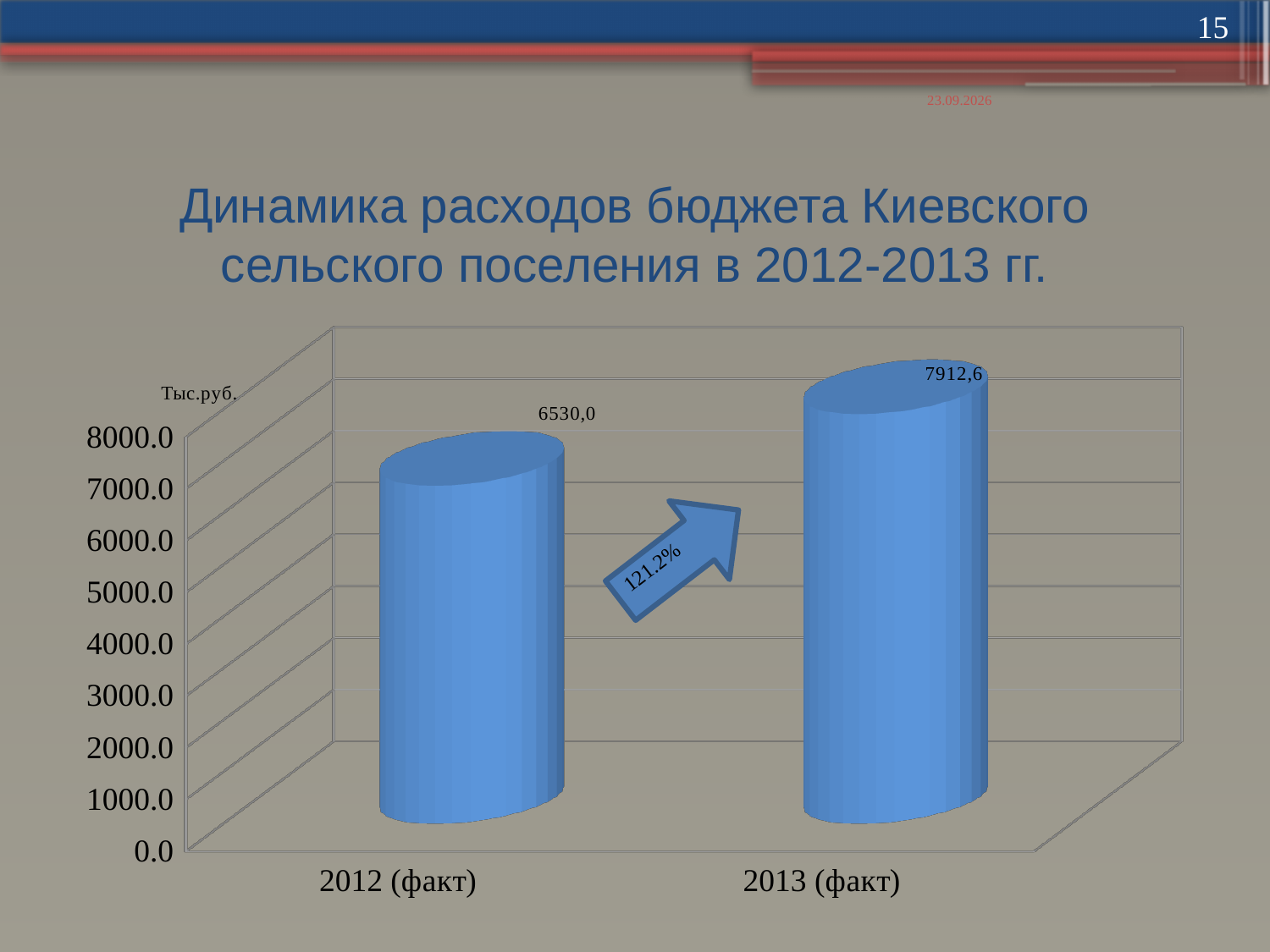
Is the value for 2013 (факт) greater or less than 7000.0? greater Do the values rise or fall from 2012 (факт) to 2013 (факт)? rise Is the value for 2012 (факт) greater or less than 7000.0? less Which category has the lowest value? 2012 (факт) What is the difference between the values for 2013 (факт) and 2012 (факт)? 1382,6 What kind of chart is shown on the slide? bar chart What is the value for 2013 (факт)? 7912,6 What percentage is written on the arrow between the two bars? 121.2% What is the value for 2012 (факт)? 6530,0 Which is larger, the value for 2012 (факт) or 2013 (факт)? 2013 (факт) Which category has the highest value? 2013 (факт) How many categories are shown on the x axis? 2